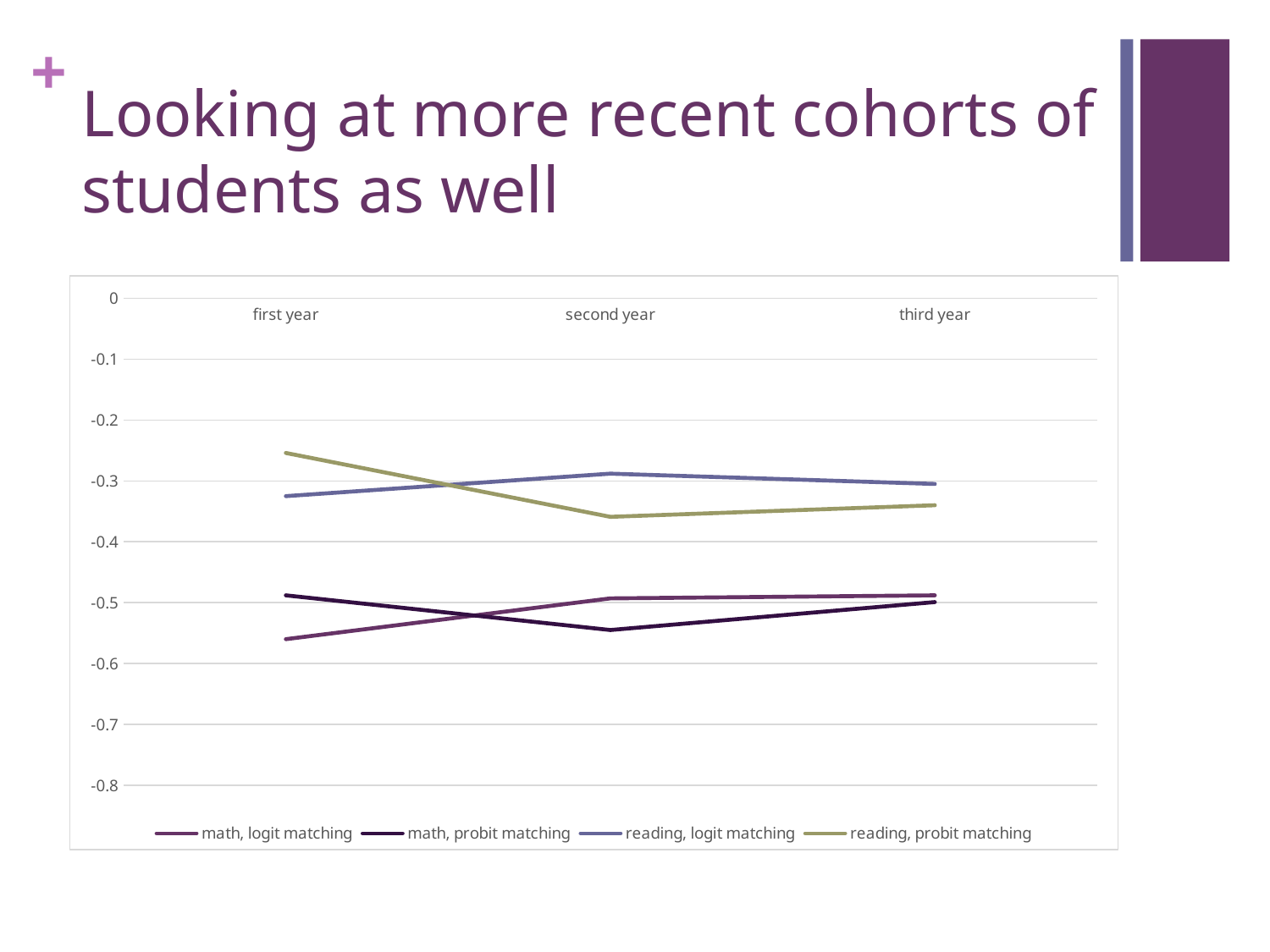
What kind of chart is shown on the slide? line chart Which series has the lowest value in the first year? math, logit matching Which series has the highest value in the first year? reading, probit matching Is the value for reading, probit matching in the second year greater or less than -0.3? less In the second year, which is higher: reading, logit matching or reading, probit matching? reading, logit matching How many series does the chart legend list? 4 Does the math, logit matching line rise or fall from the first year to the second year? rise Is the value for math, probit matching in the second year greater or less than -0.5? less How many categories are shown along the x axis? 3 Which series is drawn in the green line? reading, probit matching Is the value for reading, probit matching in the first year greater or less than -0.3? greater